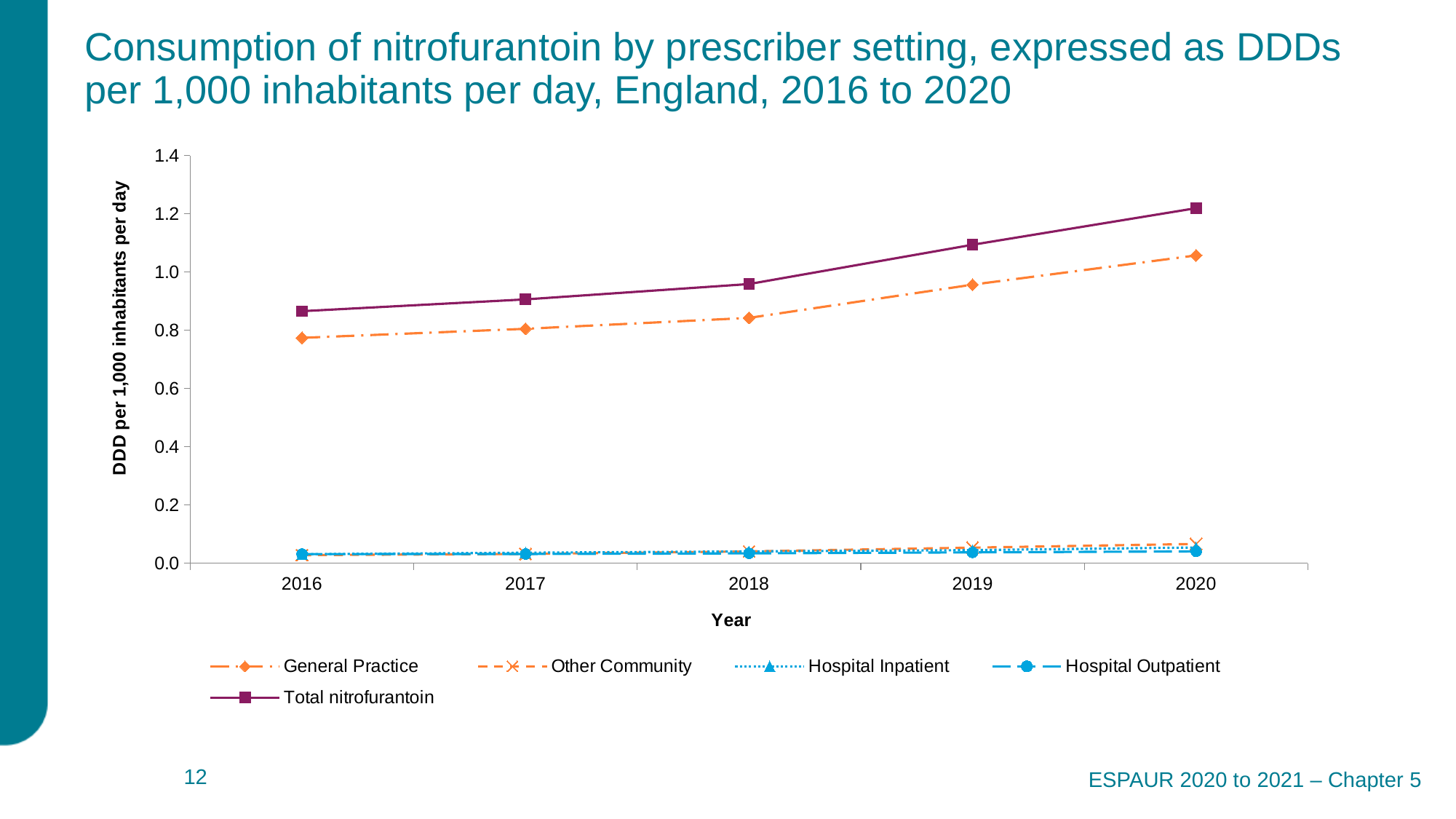
Is the value for Hospital Outpatient in 2020 greater or less than 0.2? less Is the value for Total nitrofurantoin in 2020 greater or less than 1.0? greater How many years are plotted along the x axis? 5 What is the title of the x axis? Year How many series does the legend list? 5 In which year is the Total nitrofurantoin value lowest? 2016 What kind of chart is shown on the slide? line chart Does the Total nitrofurantoin series rise or fall from 2016 to 2020? rise Which series has the highest value in 2020? Total nitrofurantoin In 2019, which is larger: General Practice or Hospital Inpatient? General Practice Is the value for General Practice in 2020 greater or less than 1.0? greater Does the General Practice series rise or fall from 2016 to 2020? rise